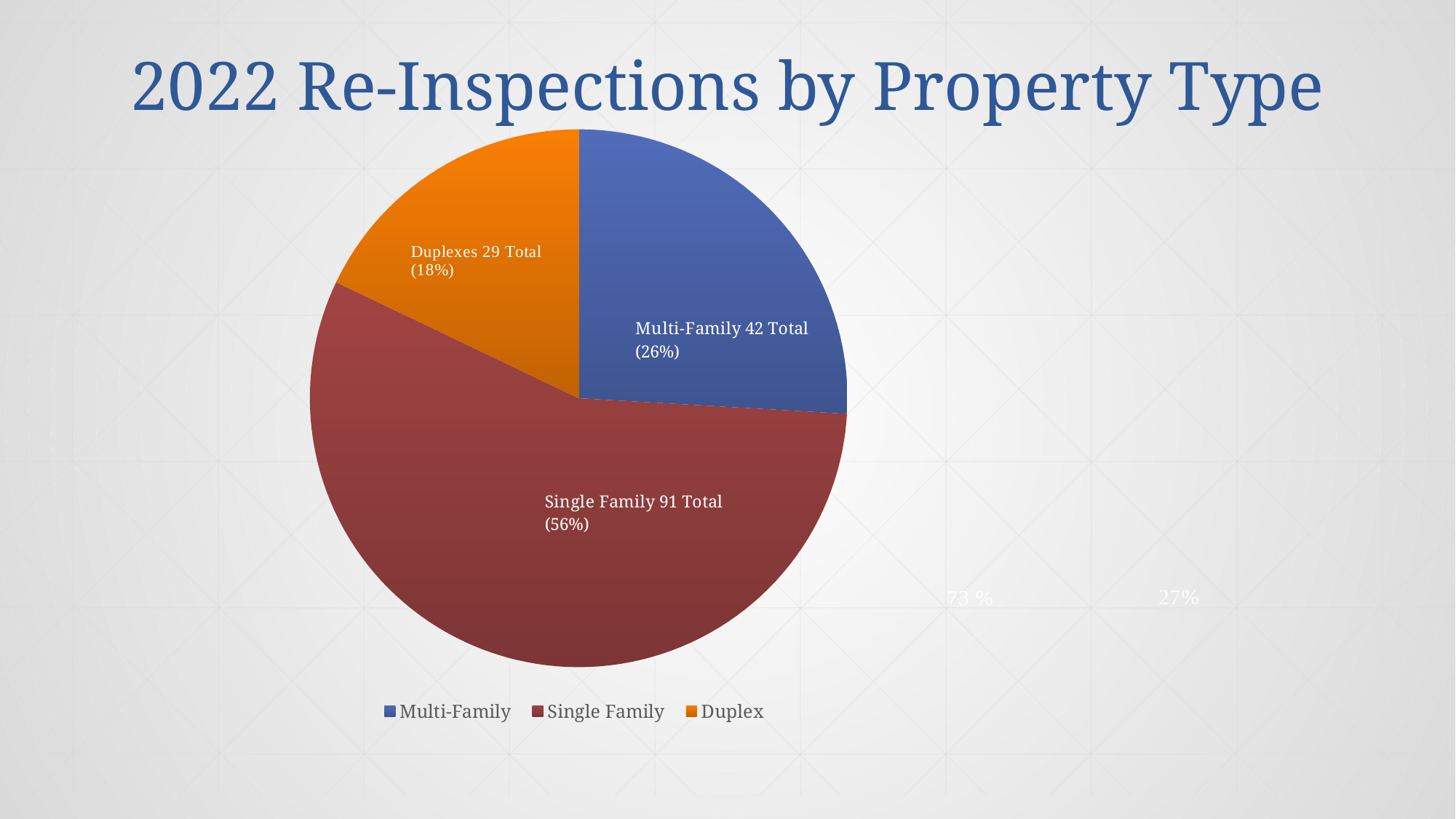
What share of the pie does Single Family represent? 56% How many re-inspections were there for Multi-Family properties? 42 What is the title of the chart? 2022 Re-Inspections by Property Type What share of the pie does Duplexes represent? 18% What kind of chart is shown on the slide? pie chart Which property type has the smallest slice? Duplexes How many re-inspections were there for Single Family properties? 91 How many slices does the pie chart have? 3 How many re-inspections were there for Duplexes? 29 What is the difference between the Single Family total and the Multi-Family total? 49 How many entries does the legend list? 3 Which property type has the largest slice? Single Family